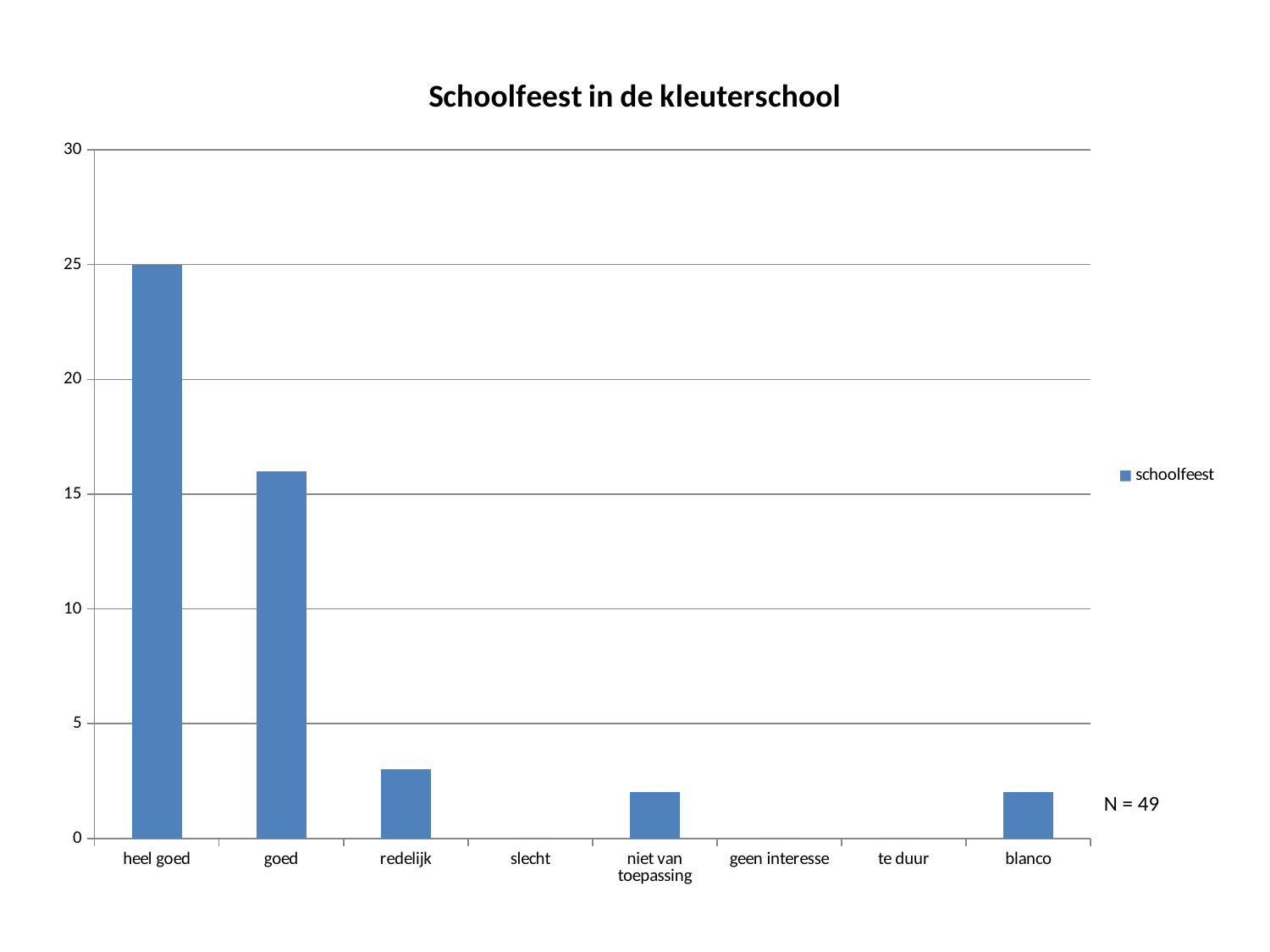
Is the value for 'niet van toepassing' greater or less than 5? less What series name is shown in the legend? schoolfeest How many series does the legend list? 1 Is the value for 'goed' greater or less than 20? less What kind of chart is shown on the slide? bar chart Which category has the highest value? heel goed What is the title of the chart? Schoolfeest in de kleuterschool Is the value for 'goed' greater or less than 15? greater What is the value for 'heel goed'? 25 Which is larger, the value for 'heel goed' or the value for 'goed'? heel goed How many categories are shown on the x axis? 8